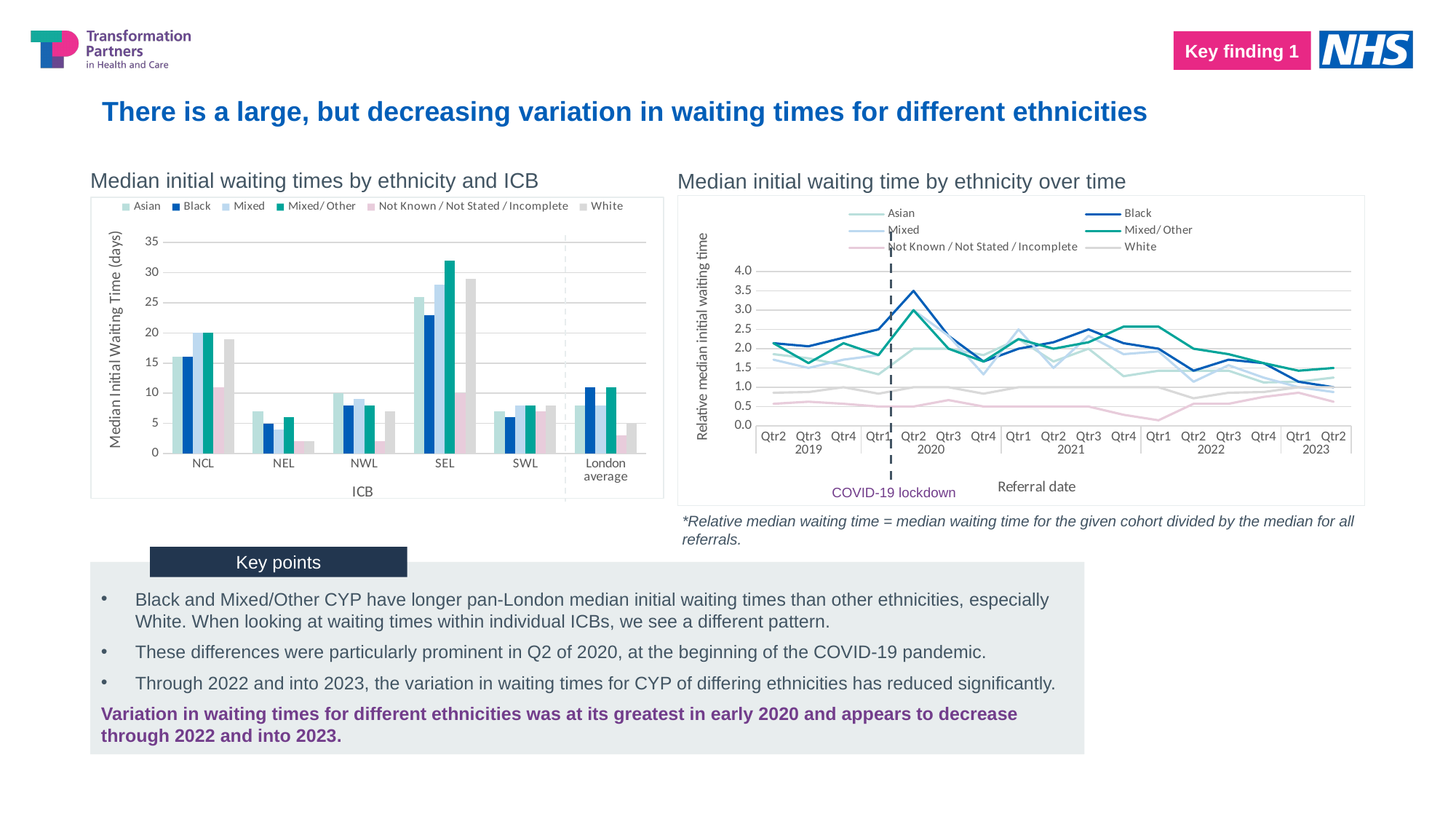
In the 'Median initial waiting times by ethnicity and ICB' chart, for the London average, which is larger: Black or White? Black In the 'Median initial waiting times by ethnicity and ICB' chart, how many series does the legend list? 6 In the 'Median initial waiting times by ethnicity and ICB' chart, is the White value for NEL greater or less than 5? less What kind of chart is the 'Median initial waiting times by ethnicity and ICB' chart? Bar chart In the 'Median initial waiting time by ethnicity over time' chart, what does the dashed vertical line mark? COVID-19 lockdown In the 'Median initial waiting time by ethnicity over time' chart, does the Black line rise or fall from Qtr2 2020 to Qtr2 2023? Fall In the 'Median initial waiting times by ethnicity and ICB' chart, is the Mixed/Other value for SEL greater or less than 30? greater In the 'Median initial waiting times by ethnicity and ICB' chart, which ICB has the highest White bar? SEL What kind of chart is the 'Median initial waiting time by ethnicity over time' chart? Line chart In the 'Median initial waiting times by ethnicity and ICB' chart, how many categories are shown on the x axis? 6 In the 'Median initial waiting time by ethnicity over time' chart, is the Black value at Qtr2 2020 greater or less than 3.0? greater In the 'Median initial waiting time by ethnicity over time' chart, which series has the lowest value at Qtr1 2022? Not Known / Not Stated / Incomplete